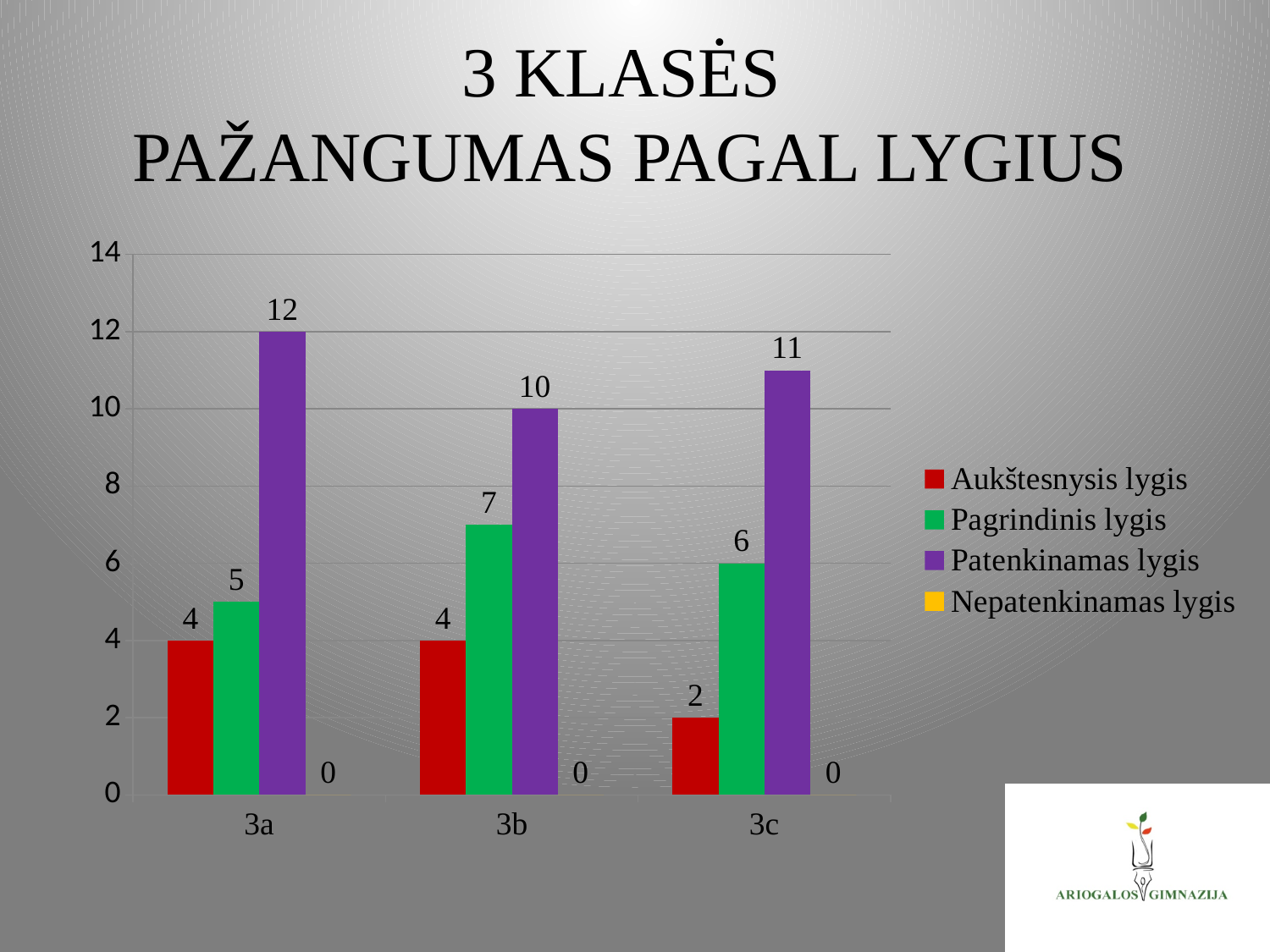
What is the value for Aukštesnysis lygis in class 3c? 2 What kind of chart is shown on the slide? bar chart How many series does the legend list? 4 Which class has the lowest value for Aukštesnysis lygis? 3c How many classes are shown on the x axis? 3 Is the value for Patenkinamas lygis in class 3c greater or less than 10? greater Which is larger: Pagrindinis lygis for 3b or Pagrindinis lygis for 3c? 3b What is the value for Nepatenkinamas lygis in every class? 0 What is the value for Pagrindinis lygis in class 3b? 7 What is the difference between the Patenkinamas lygis values for 3a and 3b? 2 What is the value for Patenkinamas lygis in class 3a? 12 Which class has the highest value for Patenkinamas lygis? 3a